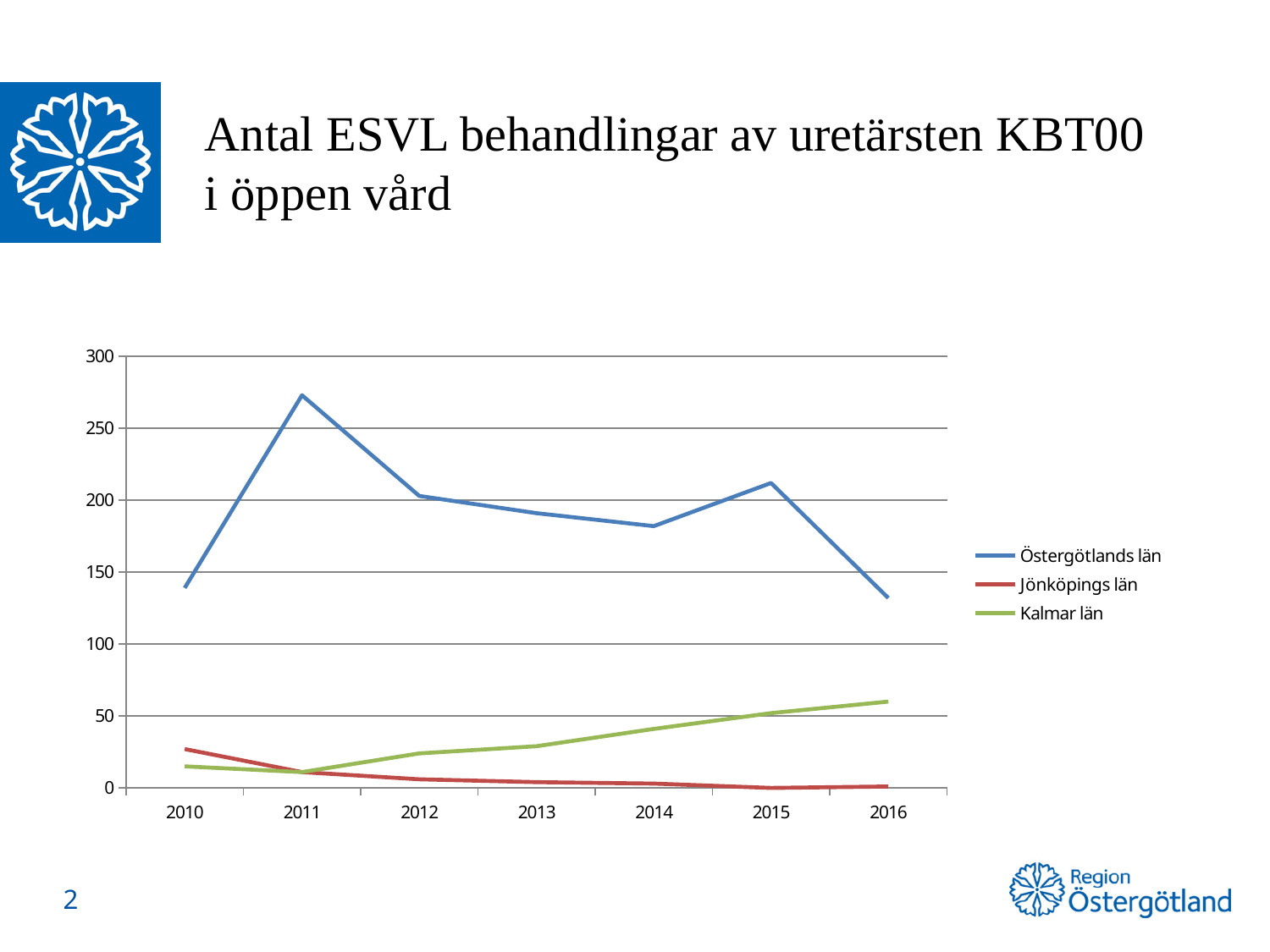
How many series does the legend list? 3 What colour is the line for Kalmar län? Green What kind of chart is shown on the slide? Line chart How many years are shown on the x axis? 7 Is the value for Östergötlands län in 2011 greater or less than 250? greater Which series has the highest values across all years? Östergötlands län In which year does Östergötlands län reach its highest value? 2011 In 2010, which is larger: Jönköpings län or Kalmar län? Jönköpings län Is the value for Kalmar län in 2016 greater or less than 50? greater Does the value for Kalmar län rise or fall from 2011 to 2016? rise Is the value for Östergötlands län in 2016 greater or less than 150? less Does the value for Jönköpings län rise or fall from 2010 to 2015? fall